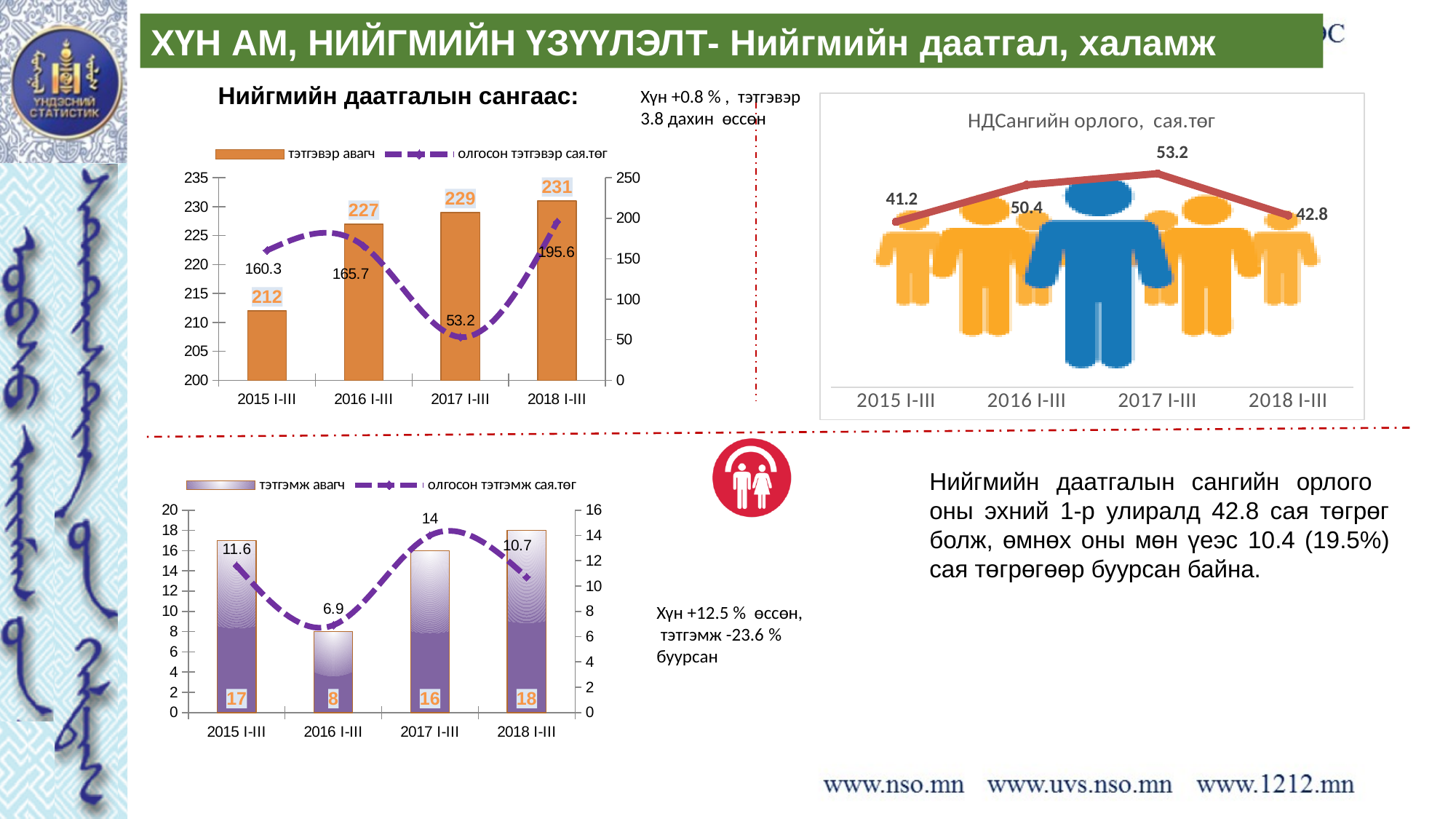
In the top-right chart (НДСангийн орлого, сая.төг), what is the difference between the values for 2017 I-III and 2018 I-III? 10.4 In the top-left chart (Нийгмийн даатгалын сангаас), what is the value of олгосон тэтгэвэр сая.төг for 2017 I-III? 53.2 In the bottom-left chart, what is the value of тэтгэмж авагч for 2016 I-III? 8 In the bottom-left chart, how many periods are shown on the x axis? 4 In the top-left chart (Нийгмийн даатгалын сангаас), what is the value of тэтгэвэр авагч for 2018 I-III? 231 What is the title of the top-right chart? НДСангийн орлого, сая.төг In the top-right chart (НДСангийн орлого, сая.төг), which period has the highest value? 2017 I-III In the top-left chart (Нийгмийн даатгалын сангаас), what is the difference between the тэтгэвэр авагч values for 2018 I-III and 2015 I-III? 19 In the top-left chart (Нийгмийн даатгалын сангаас), how many series does the legend list? 2 In the bottom-left chart, which period has the highest олгосон тэтгэмж сая.төг value? 2017 I-III In the top-left chart (Нийгмийн даатгалын сангаас), which period has the lowest тэтгэвэр авагч value? 2015 I-III In the top-right chart (НДСангийн орлого, сая.төг), what is the value for 2016 I-III? 50.4